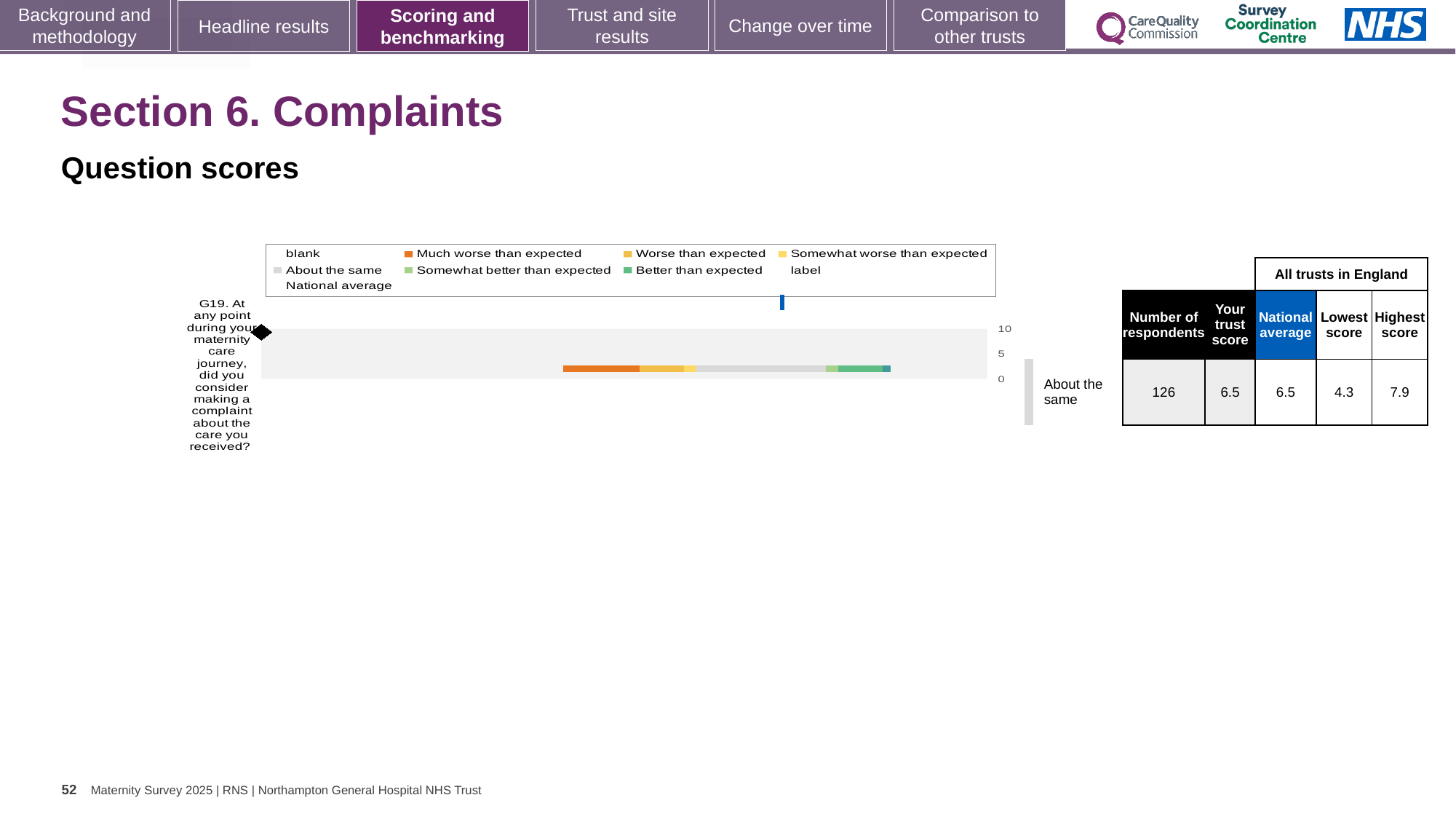
What is the difference between the highest and lowest scores for question G19? 3.6 Which benchmark category is the trust's result for G19 placed in? About the same By how much does the trust score for G19 exceed the lowest score in England? 2.2 What is the national average score for question G19? 6.5 What is the highest score among all trusts in England for question G19? 7.9 How many respondents answered question G19? 126 What kind of chart is used to show the question score for G19? bar chart What is the lowest score among all trusts in England for question G19? 4.3 How many survey questions are plotted in the chart? 1 Is the trust score for G19 higher than, lower than, or the same as the national average? the same What is the trust score for question G19 shown in the table next to the chart? 6.5 What colour does the legend use for 'Much worse than expected'? orange